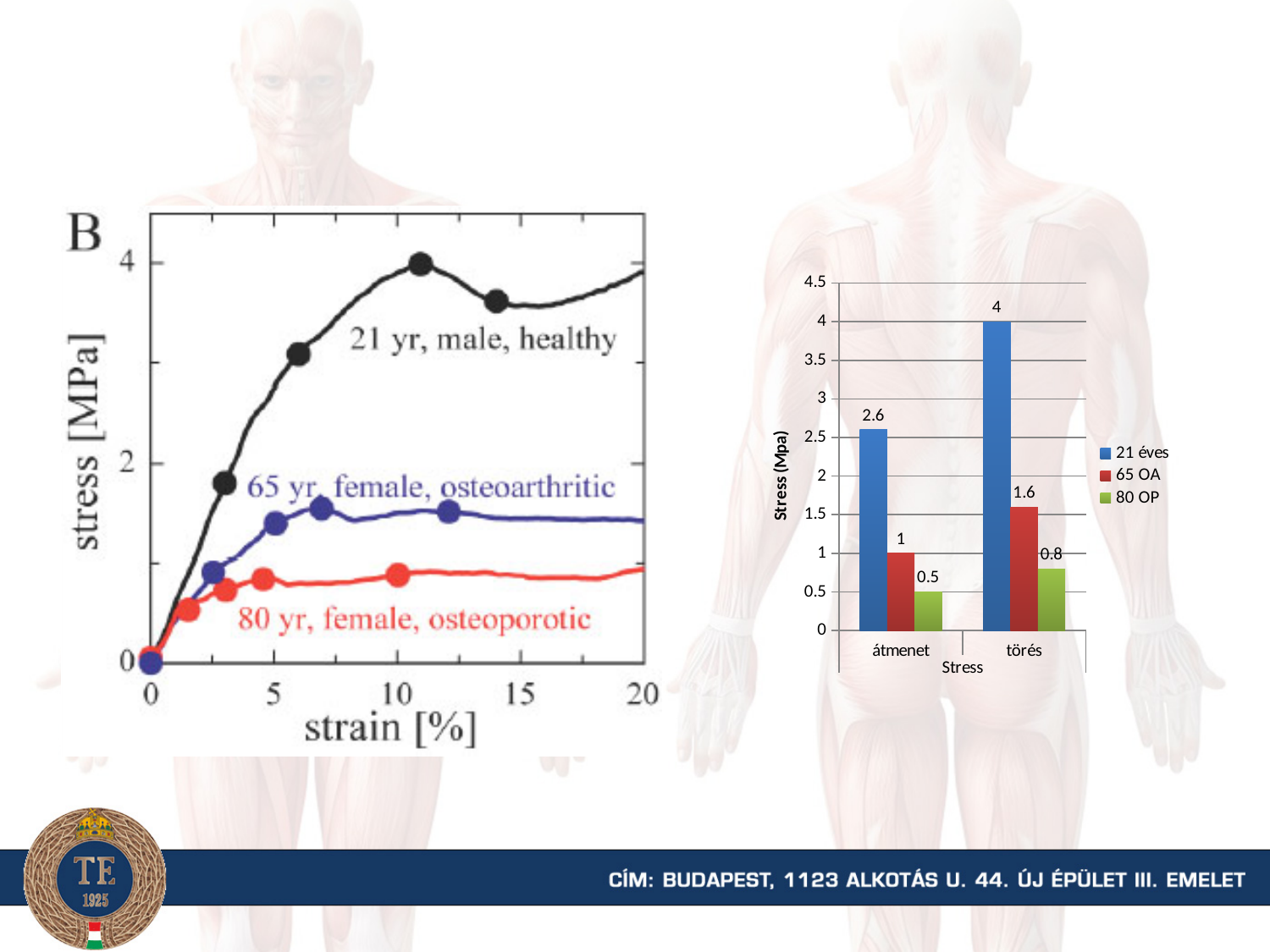
In the bar chart on the right, what is the difference between the 21 éves values for törés and átmenet? 1.4 How many categories are shown on the x axis of the bar chart on the right? 2 What kind of chart is the chart on the right side of the slide? bar chart In the bar chart on the right, what is the value for 21 éves in the átmenet category? 2.6 In the bar chart on the right, which series has the highest value in the törés category? 21 éves How many series does the legend of the bar chart on the right list? 3 In the bar chart on the right, what is the value for 65 OA in the törés category? 1.6 In the bar chart on the right, what is the value for 80 OP in the átmenet category? 0.5 In the bar chart on the right, which is larger: the 65 OA value for átmenet or the 80 OP value for törés? 65 OA value for átmenet In the line chart on the left, is the peak stress of the 21 yr, male, healthy curve greater or less than 2 MPa? greater What is the y-axis title of the bar chart on the right? Stress (Mpa) In the bar chart on the right, which series has the lowest value in the átmenet category? 80 OP